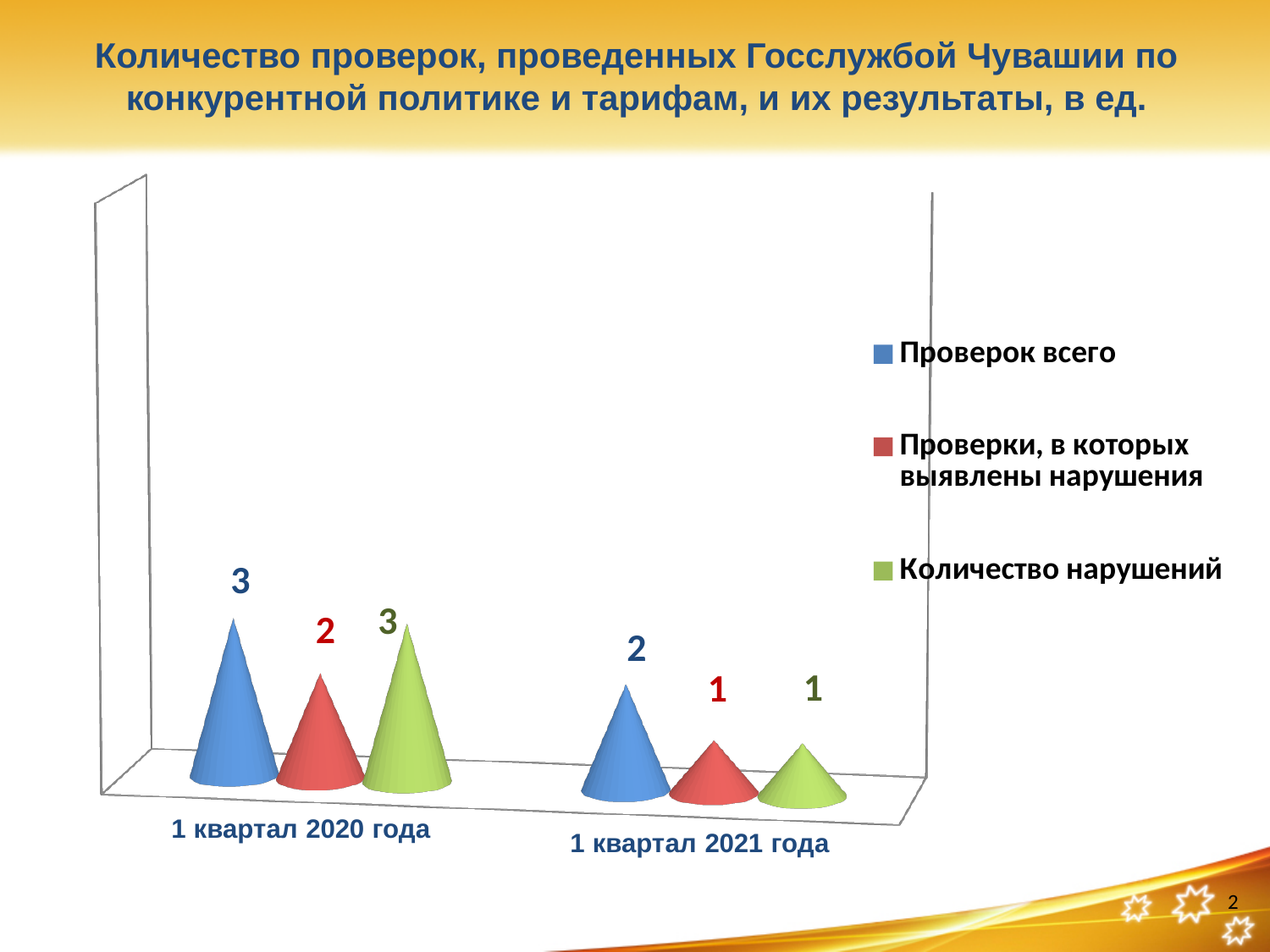
What is the value of "Проверки, в которых выявлены нарушения" for "1 квартал 2021 года"? 1 What kind of chart is shown on the slide? Bar chart What is the value of "Проверок всего" for "1 квартал 2020 года"? 3 Does the value of "Проверок всего" rise or fall from 1 квартал 2020 года to 1 квартал 2021 года? Fall What is the value of "Количество нарушений" for "1 квартал 2020 года"? 3 Which category has the higher value for "Проверок всего"? 1 квартал 2020 года Which is larger: "Проверок всего" for 1 квартал 2020 года or for 1 квартал 2021 года? 1 квартал 2020 года How many categories are shown on the x axis? 2 How many series does the legend list? 3 What is the value of "Проверок всего" for "1 квартал 2021 года"? 2 What is the value of "Проверки, в которых выявлены нарушения" for "1 квартал 2020 года"? 2 What is the difference between "Количество нарушений" in 1 квартал 2020 года and 1 квартал 2021 года? 2